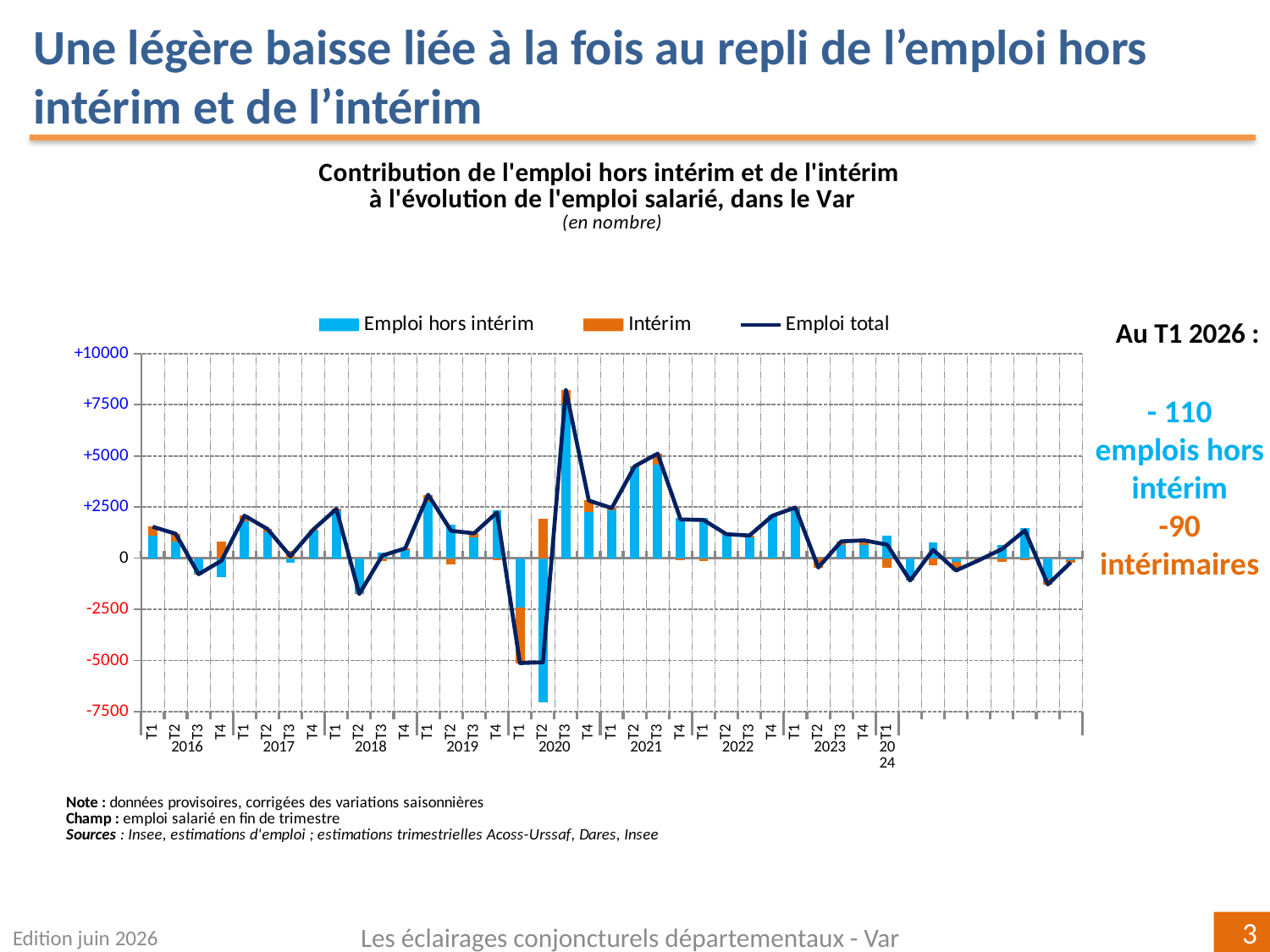
How many series does the chart legend list? 3 Does the Emploi total line rise or fall between T3 2020 and T4 2020? Fall Which series is drawn as a line rather than bars? Emploi total According to the annotation on the right, what is the change in emplois hors intérim at T1 2026? -110 Is the Emploi hors intérim bar at T2 2020 greater or less than -5000? less What kind of chart is shown on the slide? A combination chart with stacked bars and a line Which is larger, the Emploi total value at T3 2020 or at T3 2021? T3 2020 Is the Emploi total value at T3 2020 greater or less than 5000? greater What are the three series listed in the chart legend? Emploi hors intérim, Intérim, Emploi total In which quarter does the Emploi total line reach its highest value? T3 2020 Is the Emploi total value at T2 2020 greater or less than -2500? less